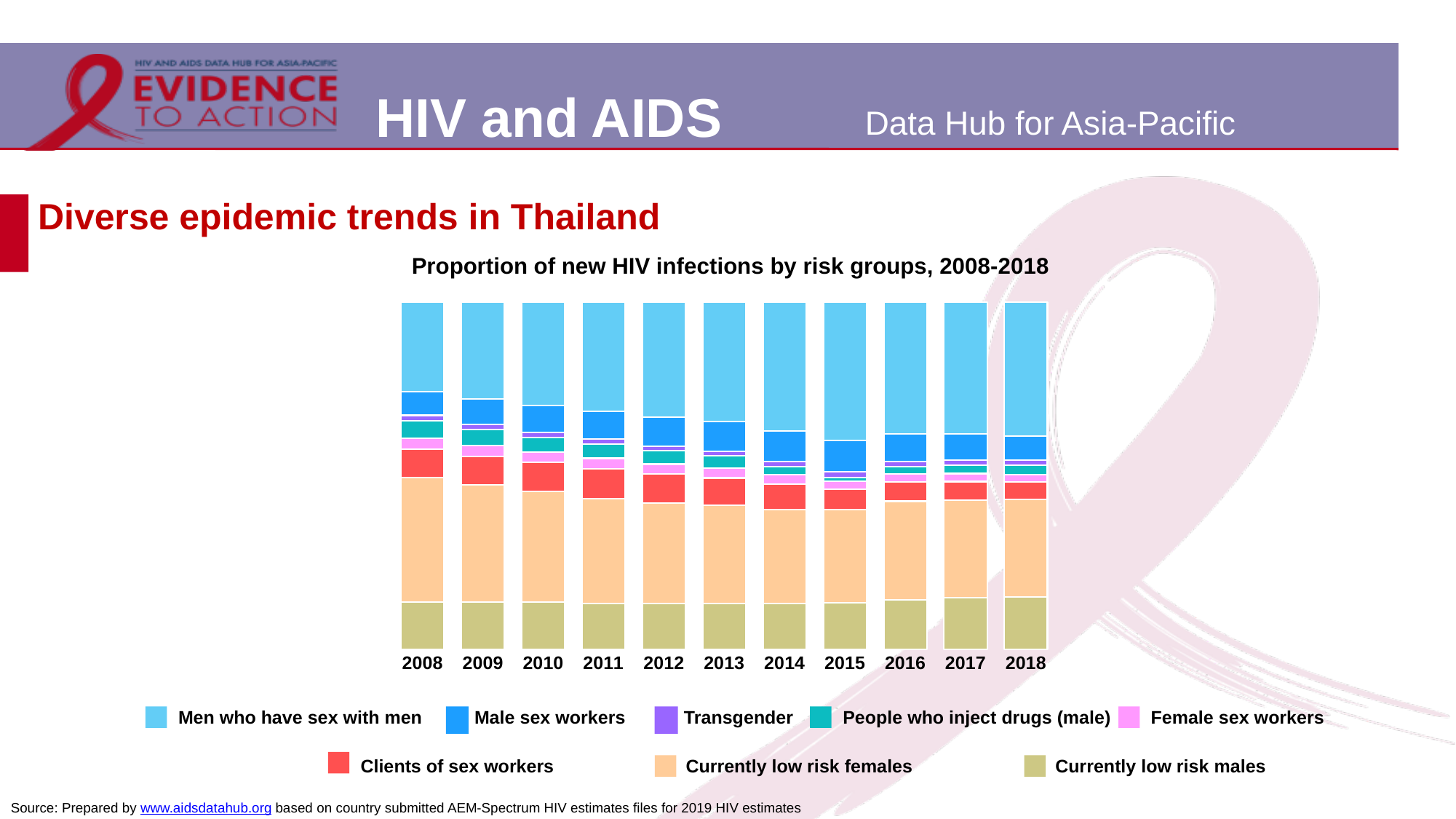
Which risk group is shown at the bottom of each stacked bar? Currently low risk males Which risk group is shown in the light blue colour at the top of each bar? Men who have sex with men Does the share of new infections among clients of sex workers rise or fall from 2008 to 2018? Fall Does the share of new infections among men who have sex with men rise or fall from 2008 to 2018? Rise Which year is the last shown on the x axis? 2018 What is the title of the chart? Proportion of new HIV infections by risk groups, 2008-2018 How many risk groups does the legend list? 8 Which year is the first shown on the x axis? 2008 Is the segment for men who have sex with men larger in 2008 or in 2018? 2018 What kind of chart is shown on the slide? Stacked bar chart How many years are shown along the x axis of the chart? 11 Is the segment for clients of sex workers larger in 2008 or in 2018? 2008